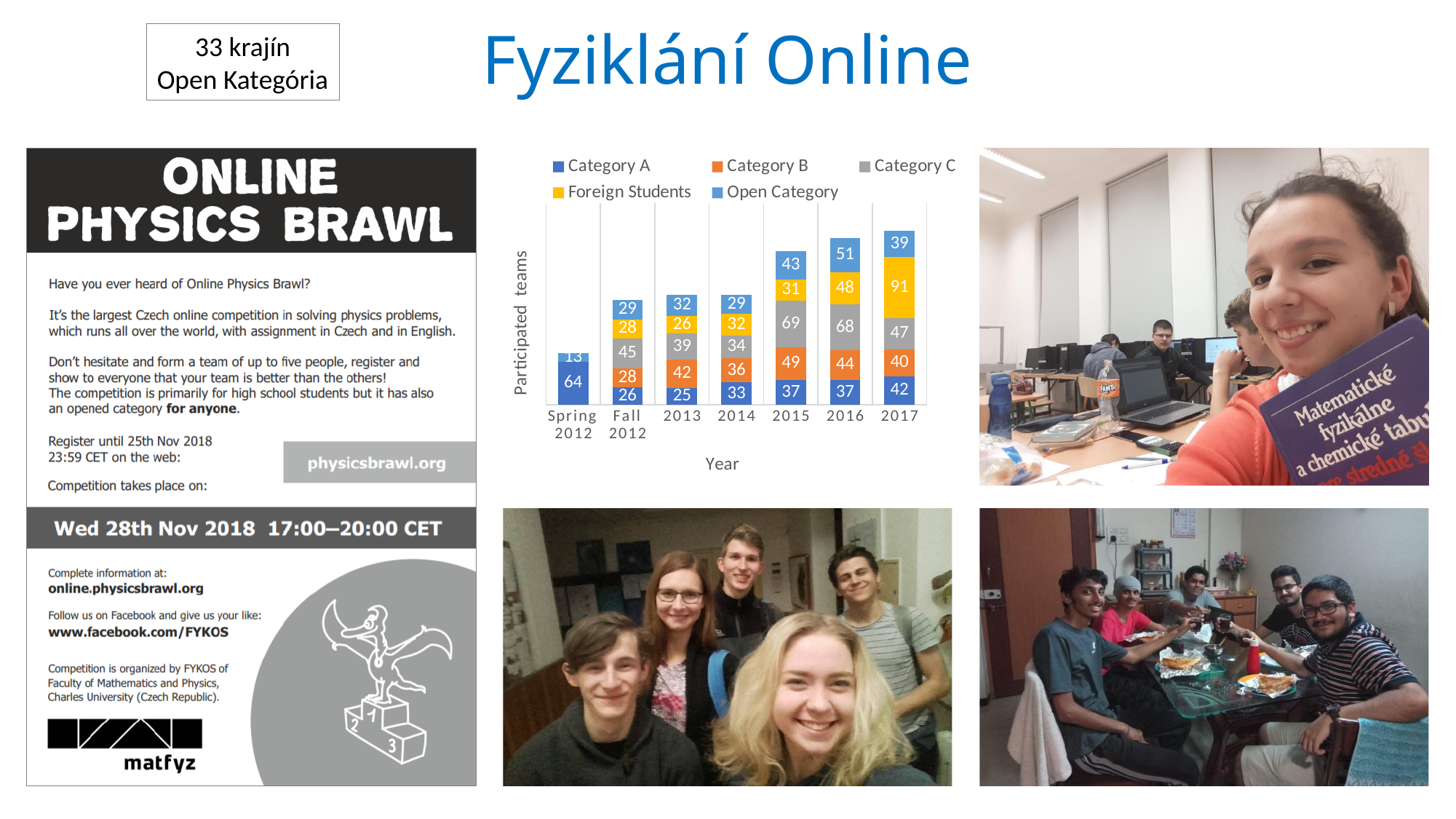
What is the difference between the Open Category values in 2016 and 2017? 12 How many year categories are shown on the x axis of the chart? 7 In which year is the Foreign Students value highest? 2017 What is the total number of participated teams in 2016 (sum of all segments)? 248 How many series does the chart legend list? 5 What is the value for Category A in Spring 2012? 64 What is the value for Category C in 2015? 69 In which year is the Category A value lowest? 2013 Which is larger, Category B in 2015 or Category B in 2016? Category B in 2015 What kind of chart is shown on the slide? stacked bar chart What is the label of the y axis of the chart? Participated teams What is the value for Foreign Students in 2017? 91